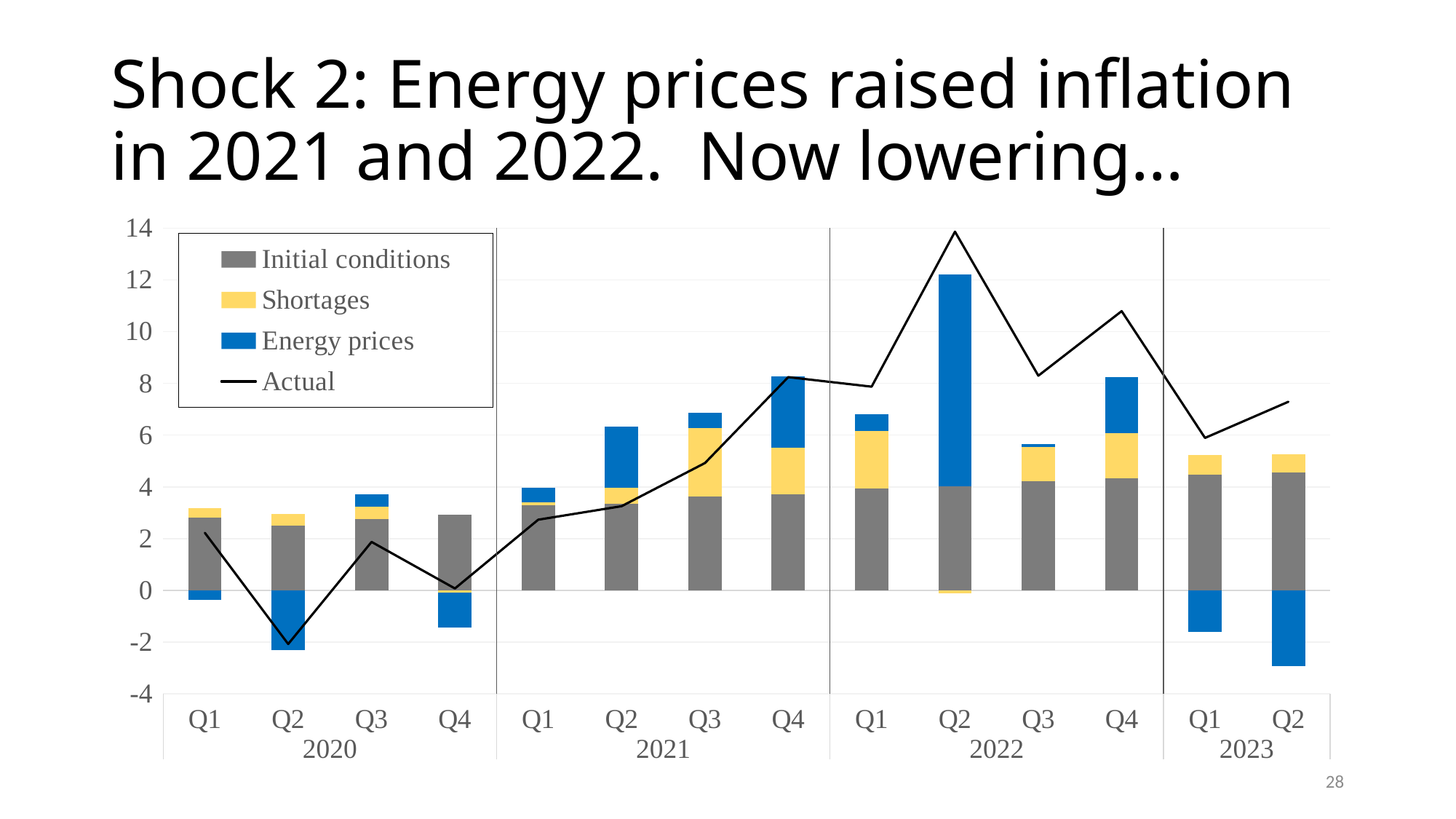
Does the Actual line rise or fall from Q4 2020 to Q4 2021? rise Which is larger, the Actual value for Q3 2020 or for Q4 2020? Q3 2020 Is the Actual value for Q4 2022 greater or less than 10? greater In which quarter does the Actual line reach its lowest value? Q2 2020 Is the Actual value for Q2 2022 greater or less than 12? greater How many quarters are plotted along the x axis? 14 In which quarter does the Actual line reach its highest value? Q2 2022 Is the Actual value for Q2 2020 greater or less than 0? less What colour represents Energy prices in the legend? Blue How many series does the legend list? 4 What kind of chart is shown on the slide? Stacked bar chart with a line